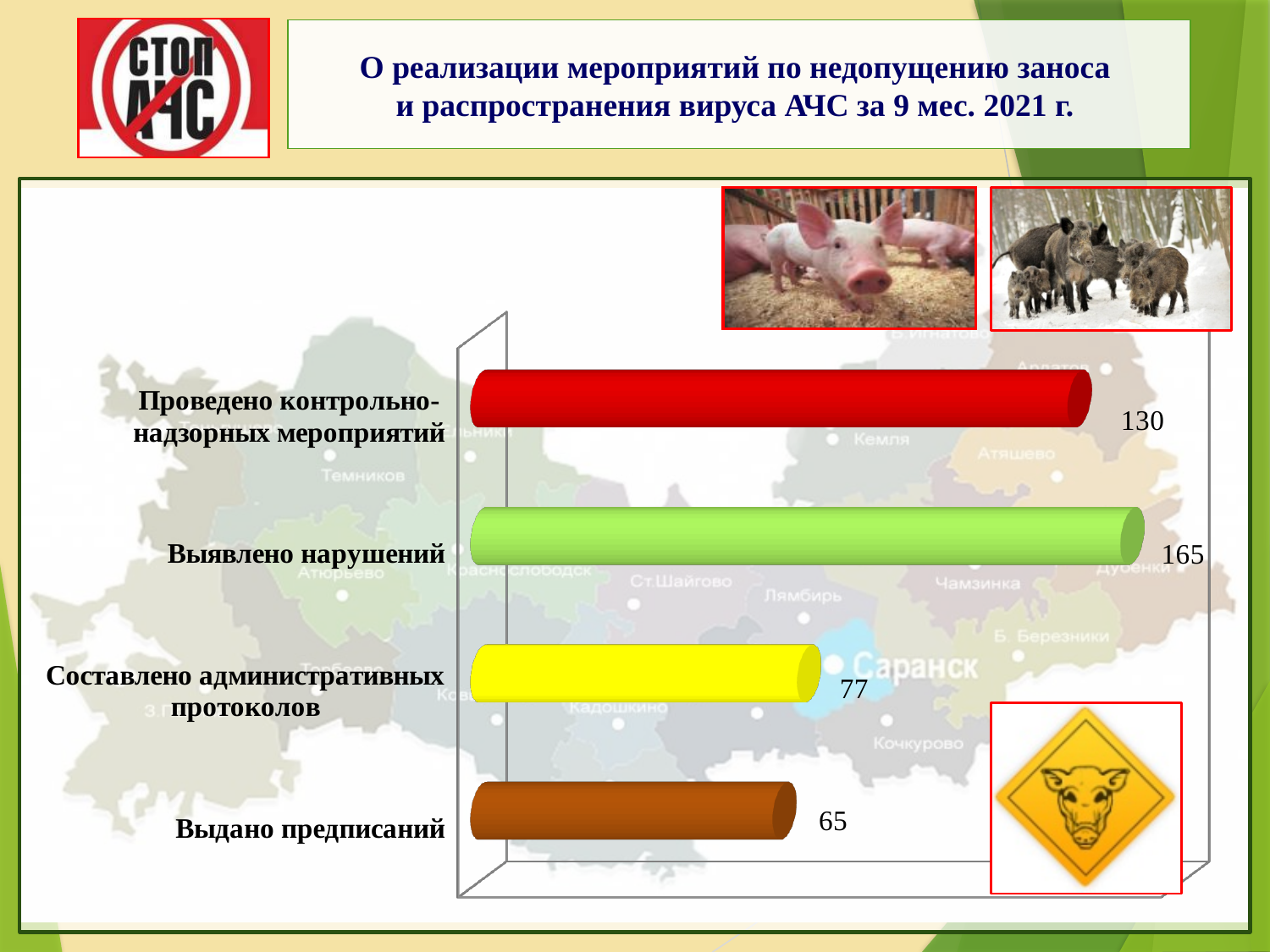
What is the difference between the values for "Составлено административных протоколов" and "Выдано предписаний"? 12 Which is larger: the value for "Проведено контрольно-надзорных мероприятий" or for "Составлено административных протоколов"? Проведено контрольно-надзорных мероприятий What value is shown for "Выдано предписаний"? 65 What value is shown for "Выявлено нарушений"? 165 What is the difference between the values for "Выявлено нарушений" and "Проведено контрольно-надзорных мероприятий"? 35 Which category has the highest value? Выявлено нарушений What colour is the bar for "Выявлено нарушений"? Green How many categories are shown in the chart? 4 What value is shown for "Составлено административных протоколов"? 77 What kind of chart is shown on the slide? Bar chart What value is shown for "Проведено контрольно-надзорных мероприятий"? 130 Which category has the lowest value? Выдано предписаний